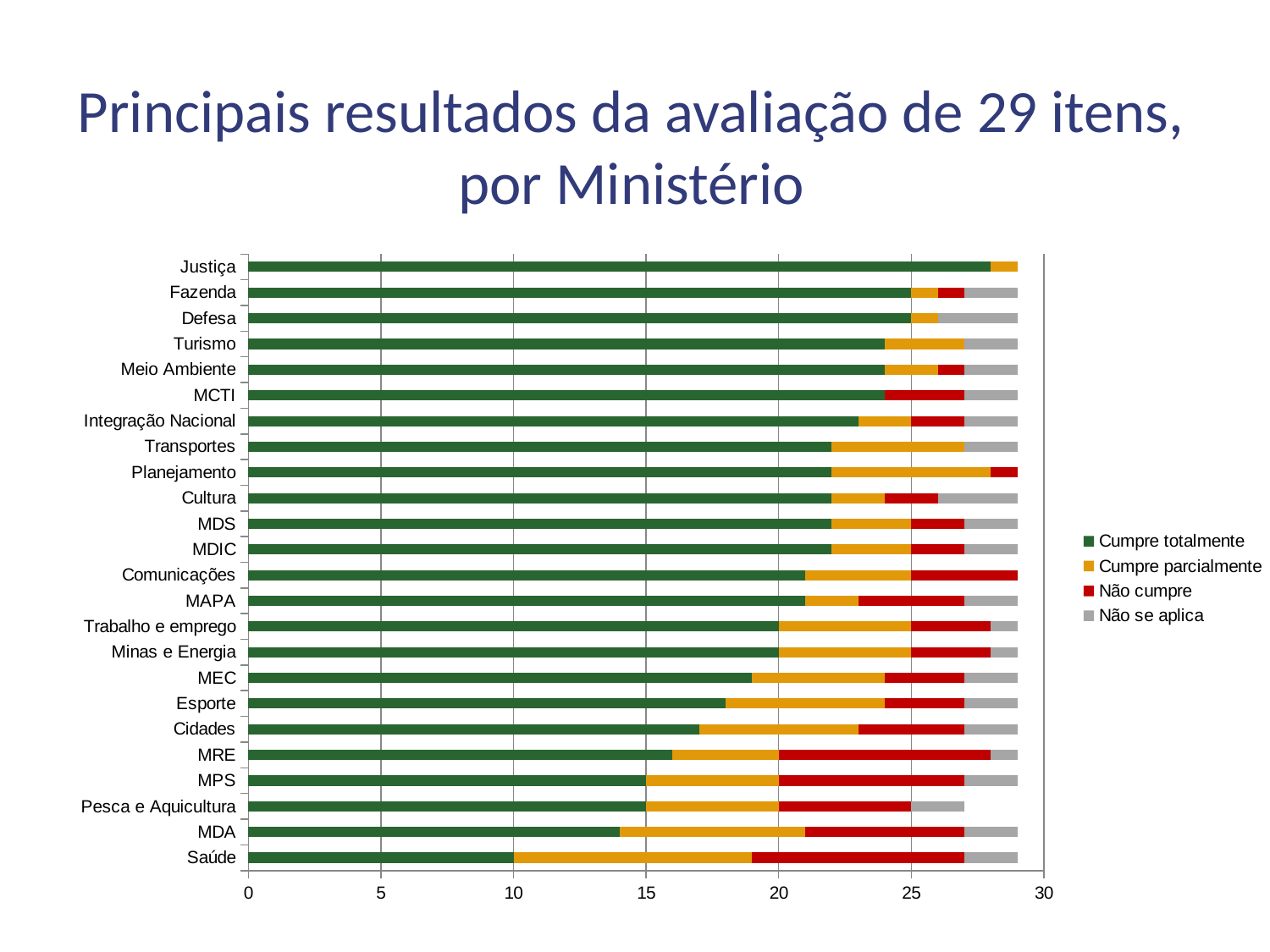
Is the 'Cumpre totalmente' value for Esporte greater or less than 20? less Moving from the top bar to the bottom bar, do the 'Cumpre totalmente' segments get longer or shorter? shorter How many series does the legend list? 4 Which ministry has the shortest 'Cumpre totalmente' segment? Saúde What kind of chart is shown on the slide? bar chart How many ministries (categories) are plotted on the chart? 24 Which colour represents 'Não cumpre' in the legend? red Which ministry has the longest 'Cumpre totalmente' segment? Justiça Is the 'Cumpre totalmente' value for Turismo greater or less than 25? less Is the 'Cumpre totalmente' value for MDA greater or less than 15? less Which has the larger 'Não cumpre' segment, Saúde or Justiça? Saúde